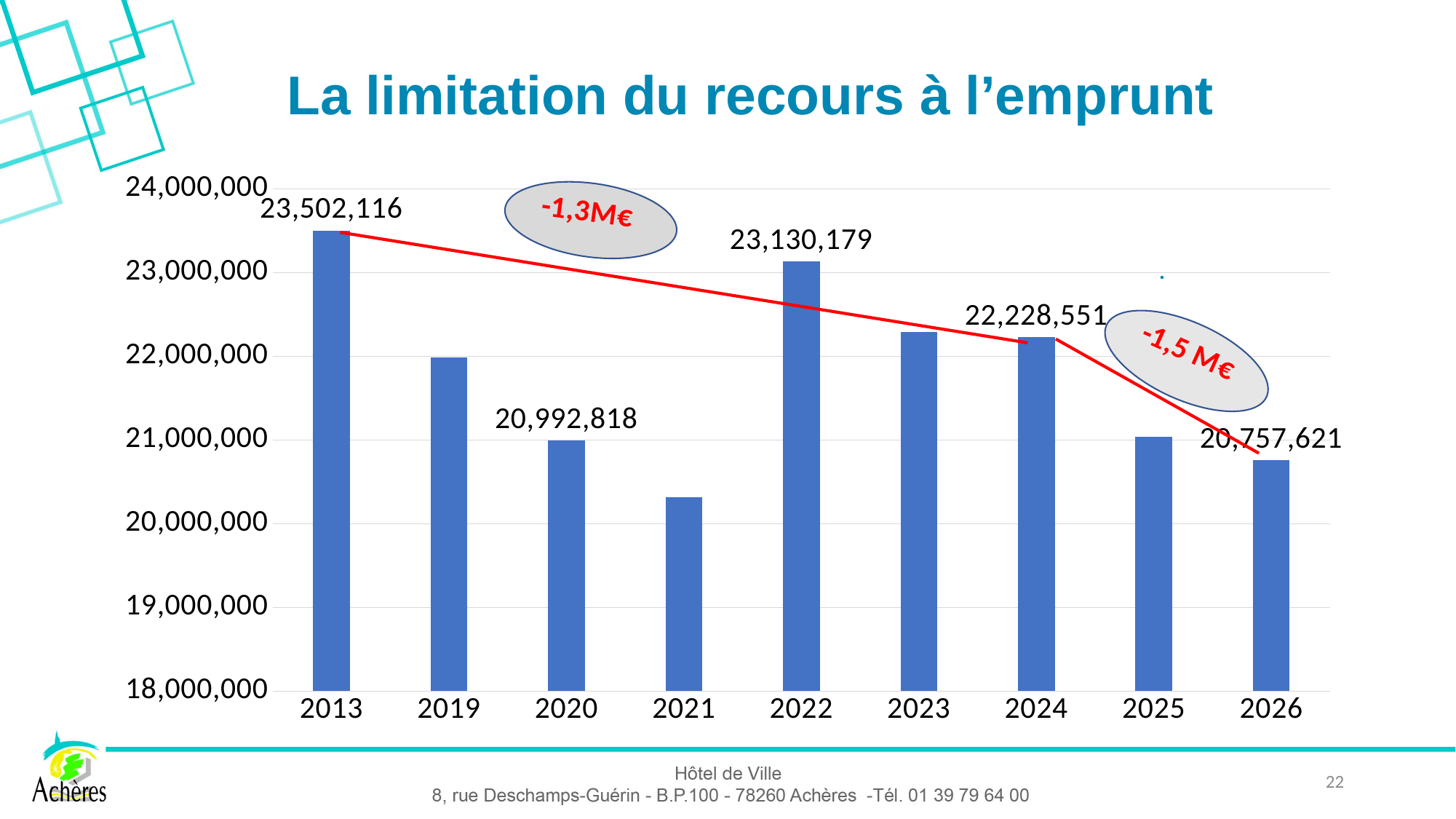
Is the value for 2023 greater or less than 22,000,000? greater What is the value for 2013? 23,502,116 Is the value for 2021 greater or less than 21,000,000? less Which year has the lowest value? 2021 Which is larger, the value for 2020 or the value for 2024? 2024 How many years are shown on the x axis? 9 What is the value for 2022? 23,130,179 What is the value for 2026? 20,757,621 What is the difference between the values for 2013 and 2022? 371,937 What is the title of the slide? La limitation du recours à l’emprunt What is the difference between the values for 2024 and 2026? 1,470,930 Which year has the highest value? 2013